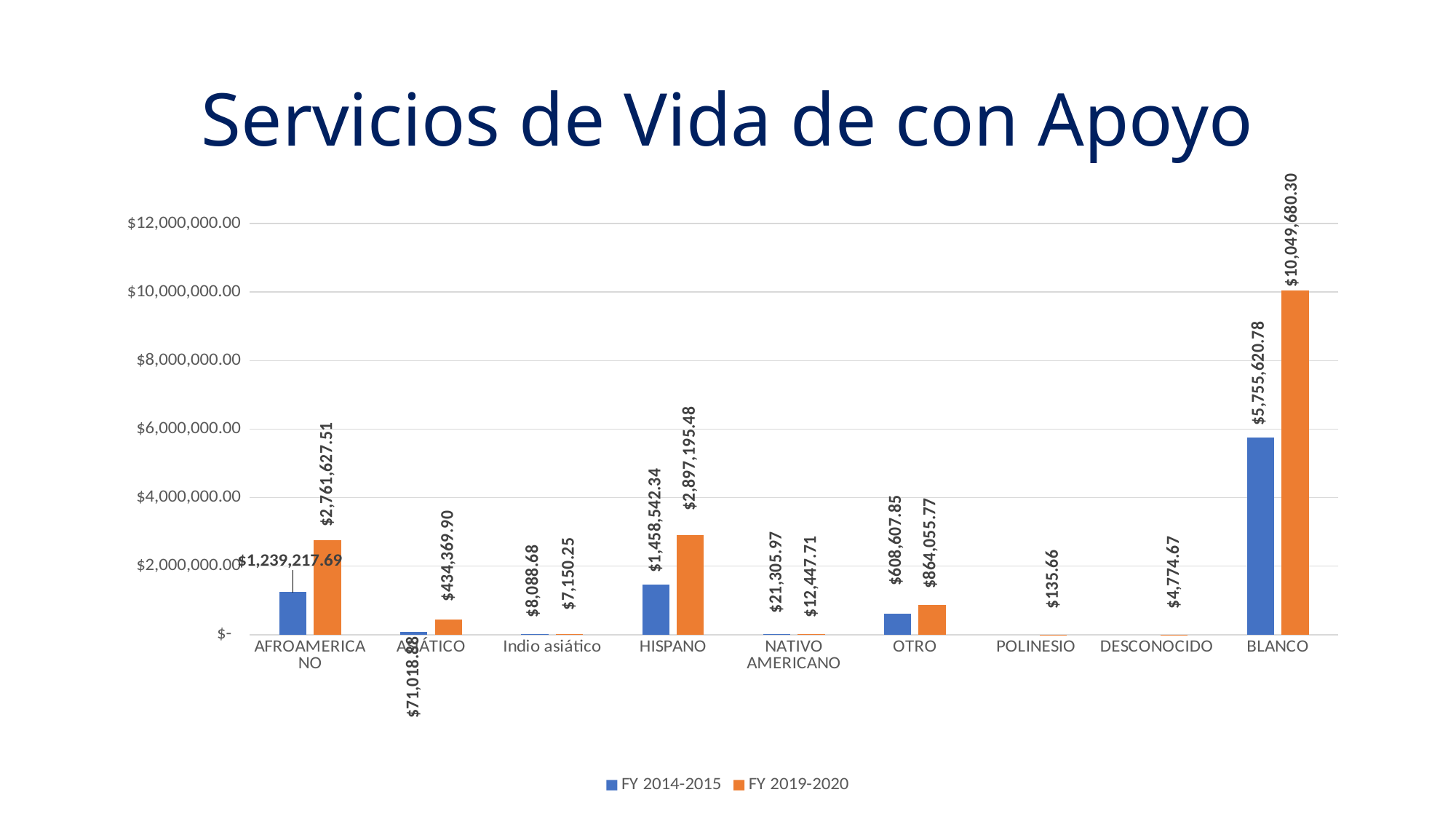
Which is larger for NATIVO AMERICANO, the FY 2014-2015 value or the FY 2019-2020 value? FY 2014-2015 How many categories are shown on the x axis? 9 What is the difference between the FY 2019-2020 and FY 2014-2015 values for BLANCO? $4,294,059.52 How many series does the legend list? 2 What is the FY 2019-2020 value for AFROAMERICANO? $2,761,627.51 What is the difference between the FY 2019-2020 and FY 2014-2015 values for HISPANO? $1,438,653.14 What type of chart is shown on the slide? Bar chart What is the FY 2014-2015 value for HISPANO? $1,458,542.34 What is the FY 2014-2015 value for OTRO? $608,607.85 Which category has the highest FY 2019-2020 value? BLANCO Is the FY 2014-2015 value for BLANCO greater or less than $4,000,000.00? greater What is the FY 2019-2020 value for BLANCO? $10,049,680.30